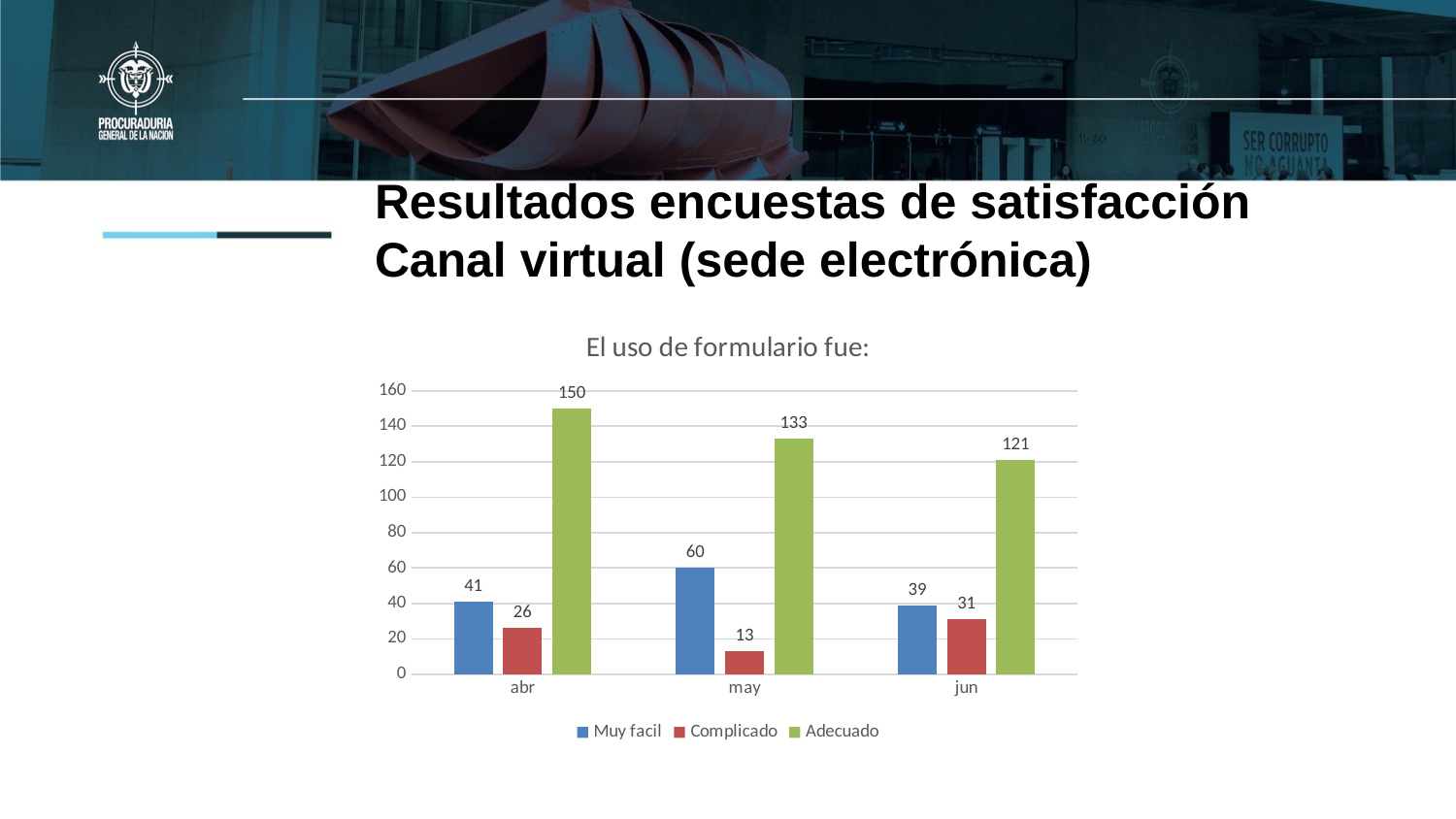
What is the difference between the Adecuado values for abr and jun? 29 What is the title of the chart? El uso de formulario fue: What is the value for Adecuado in abr? 150 Which is larger: Muy facil in may or Muy facil in abr? Muy facil in may What kind of chart is shown? bar chart Is the value for Adecuado in may greater or less than 120? greater Which month has the lowest value for Complicado? may What is the value for Muy facil in jun? 39 How many series does the legend list? 3 How many months are shown on the x axis? 3 Which month has the highest value for Adecuado? abr What is the value for Complicado in may? 13